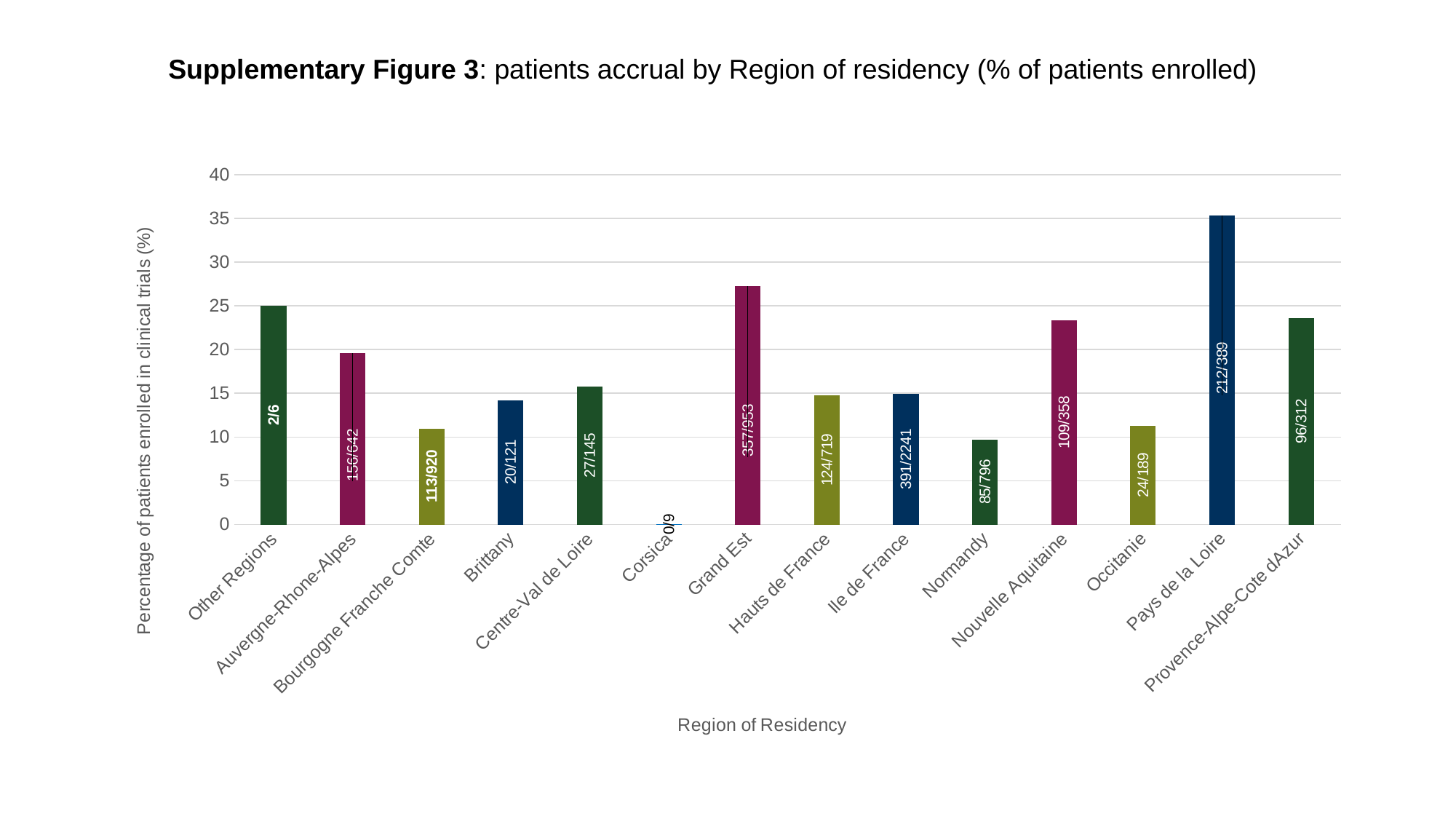
What is the title of the x axis? Region of Residency Which has a higher percentage of patients enrolled, Grand Est or Nouvelle Aquitaine? Grand Est What kind of chart is shown on the slide? bar chart How many regions (categories) are shown on the x axis? 14 What data label is printed on the bar for Ile de France? 391/2241 What data label is printed on the bar for Pays de la Loire? 212/389 What data label is printed on the bar for Corsica? 0/9 Is the value for Pays de la Loire greater or less than 30? greater What data label is printed on the bar for Brittany? 20/121 Is the value for Normandy greater or less than 15? less Which region has the lowest percentage of patients enrolled in clinical trials? Corsica Which region has the highest percentage of patients enrolled in clinical trials? Pays de la Loire